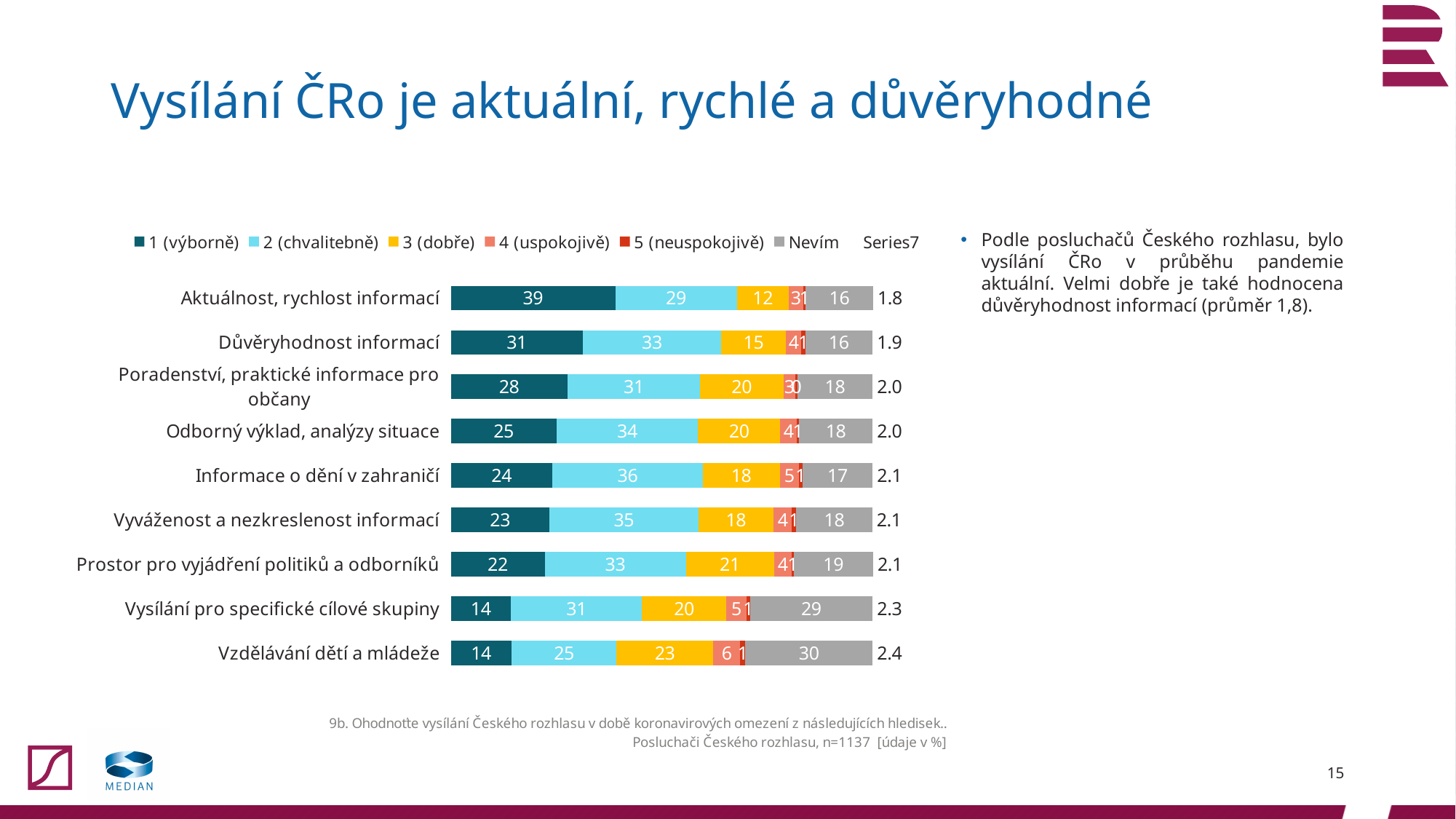
How many categories are shown in the chart? 9 What colour represents the "Nevím" series in the chart? Grey What kind of chart is shown on the slide? Stacked bar chart What is the difference between the "1 (výborně)" values for "Aktuálnost, rychlost informací" and "Důvěryhodnost informací"? 8 What is the value for "2 (chvalitebně)" for "Informace o dění v zahraničí"? 36 Which category has the lowest value for "3 (dobře)"? Aktuálnost, rychlost informací What is the value for "1 (výborně)" for "Aktuálnost, rychlost informací"? 39 How many series does the legend list? 7 Which has a larger "Nevím" value: "Vysílání pro specifické cílové skupiny" or "Vzdělávání dětí a mládeže"? Vzdělávání dětí a mládeže What is the average score shown at the end of the bar for "Vysílání pro specifické cílové skupiny"? 2.3 Which category has the highest value for "1 (výborně)"? Aktuálnost, rychlost informací What is the "Nevím" value for "Vzdělávání dětí a mládeže"? 30